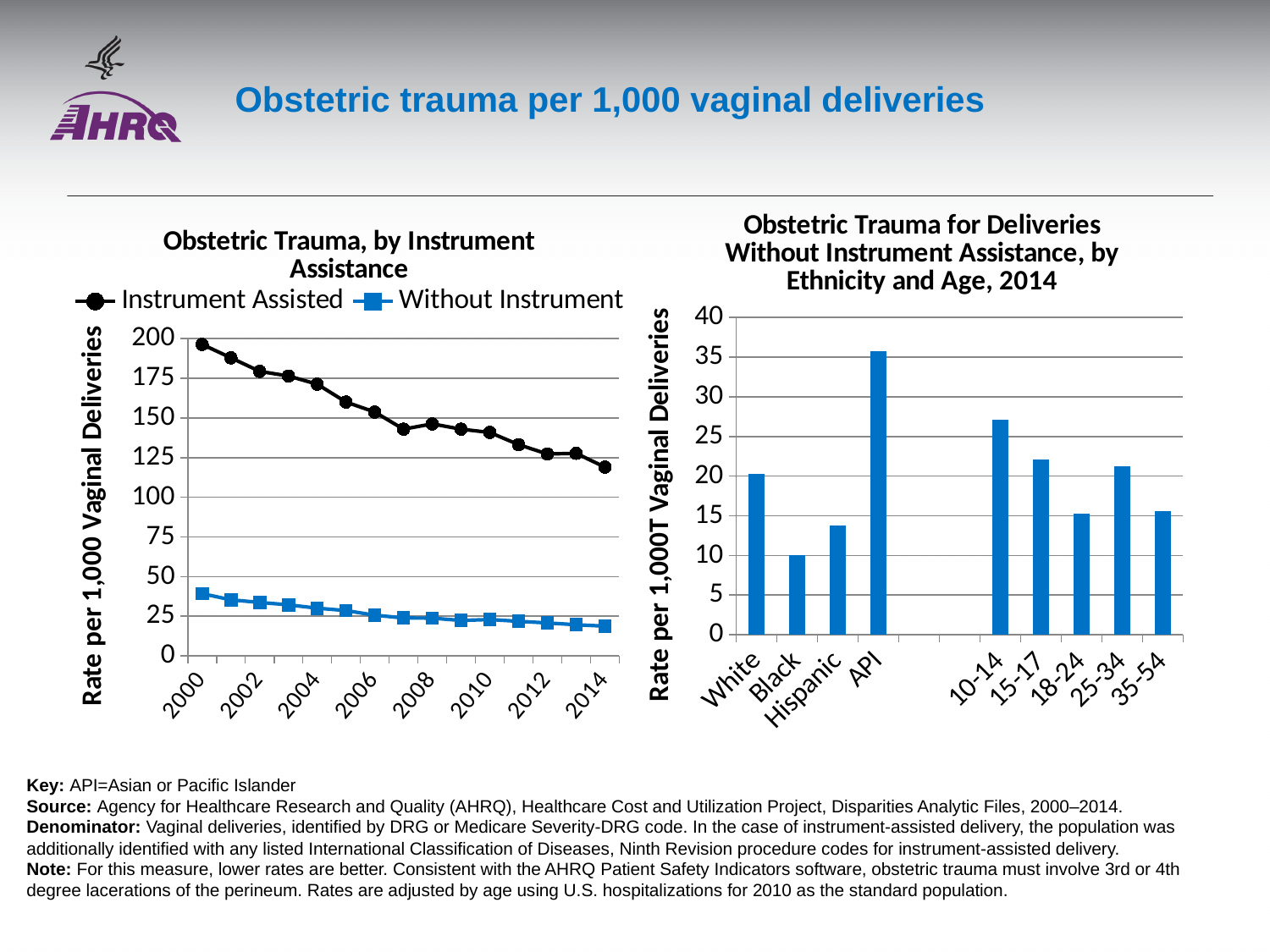
In the 'Obstetric Trauma, by Instrument Assistance' chart, does the Instrument Assisted rate rise or fall from 2000 to 2014? Fall In the 'Obstetric Trauma for Deliveries Without Instrument Assistance, by Ethnicity and Age, 2014' chart, is the value for 10-14 greater or less than 25? greater In the 'Obstetric Trauma for Deliveries Without Instrument Assistance, by Ethnicity and Age, 2014' chart, which category has the highest rate? API In the 'Obstetric Trauma, by Instrument Assistance' chart, how many series does the legend list? 2 In the 'Obstetric Trauma, by Instrument Assistance' chart, is the Instrument Assisted value for 2014 greater or less than 125? less In the 'Obstetric Trauma for Deliveries Without Instrument Assistance, by Ethnicity and Age, 2014' chart, how many categories are plotted? 9 What type of chart is the 'Obstetric Trauma, by Instrument Assistance' chart on the left? Line chart In the 'Obstetric Trauma for Deliveries Without Instrument Assistance, by Ethnicity and Age, 2014' chart, which category has the lowest rate? Black In the 'Obstetric Trauma for Deliveries Without Instrument Assistance, by Ethnicity and Age, 2014' chart, which is larger, the value for 10-14 or the value for 18-24? 10-14 In the 'Obstetric Trauma, by Instrument Assistance' chart, is the Instrument Assisted value for 2000 greater or less than 175? greater What type of chart is the 'Obstetric Trauma for Deliveries Without Instrument Assistance, by Ethnicity and Age, 2014' chart on the right? Bar chart In the 'Obstetric Trauma, by Instrument Assistance' chart, which series has the higher values throughout the period, Instrument Assisted or Without Instrument? Instrument Assisted